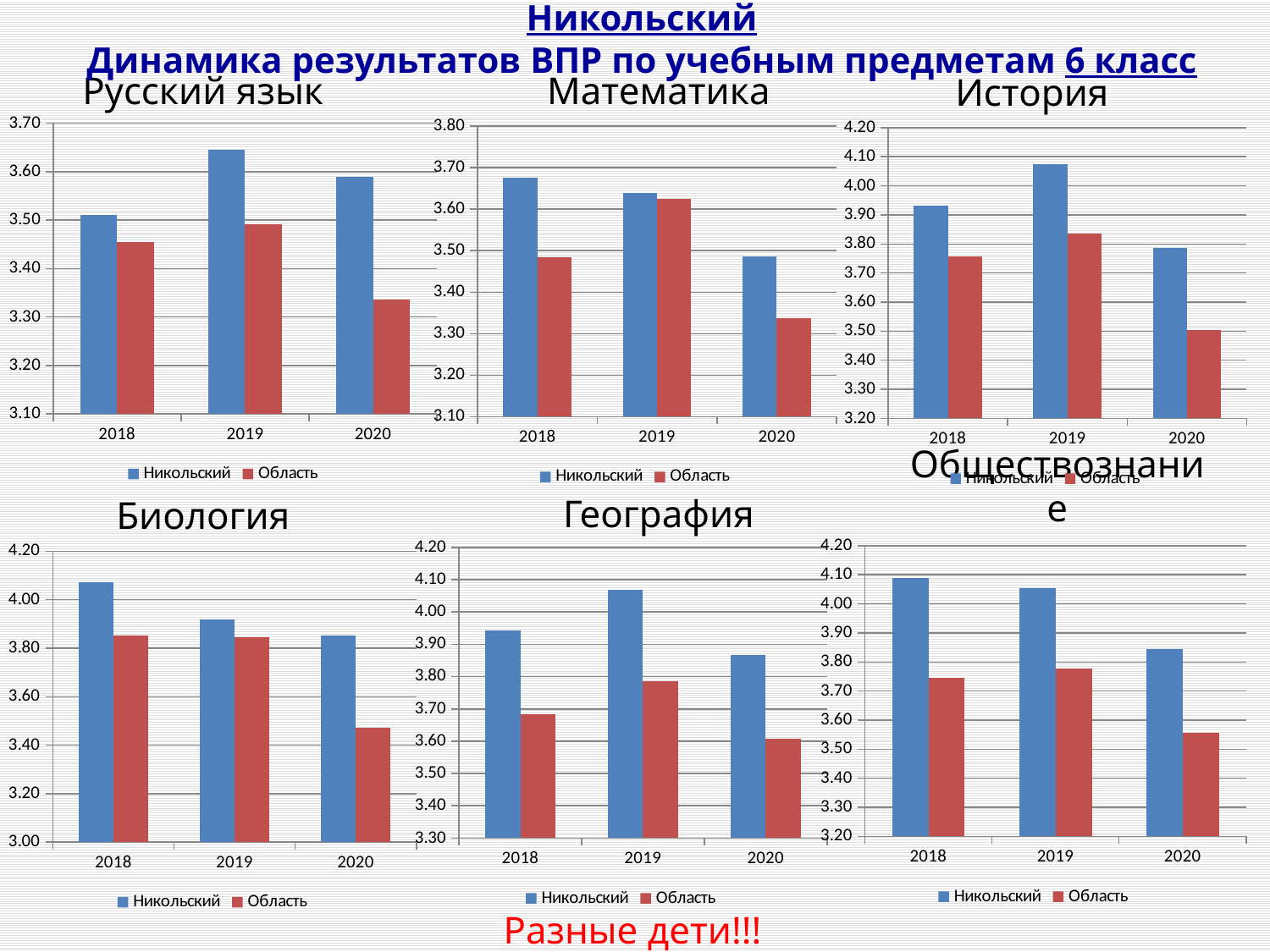
On the География chart, which is larger in 2019: Никольский or Область? Никольский On the История chart, in which year is the Область bar lowest? 2020 What kind of chart is the Математика chart? bar chart On the Обществознание chart, do the Никольский values rise or fall from 2018 to 2020? fall On the Русский язык chart, is the value for Область in 2020 greater or less than 3.40? less How many series does the legend of the Биология chart list? 2 On the Биология chart, is the value for Никольский in 2018 greater or less than 4.00? greater What are the two legend entries on the География chart? Никольский and Область On the Математика chart, in which year is the Область bar highest? 2019 On the Русский язык chart, in which year is the Никольский bar highest? 2019 On the Математика chart, is the value for Область in 2020 greater or less than 3.40? less How many years are shown on the x axis of the История chart? 3